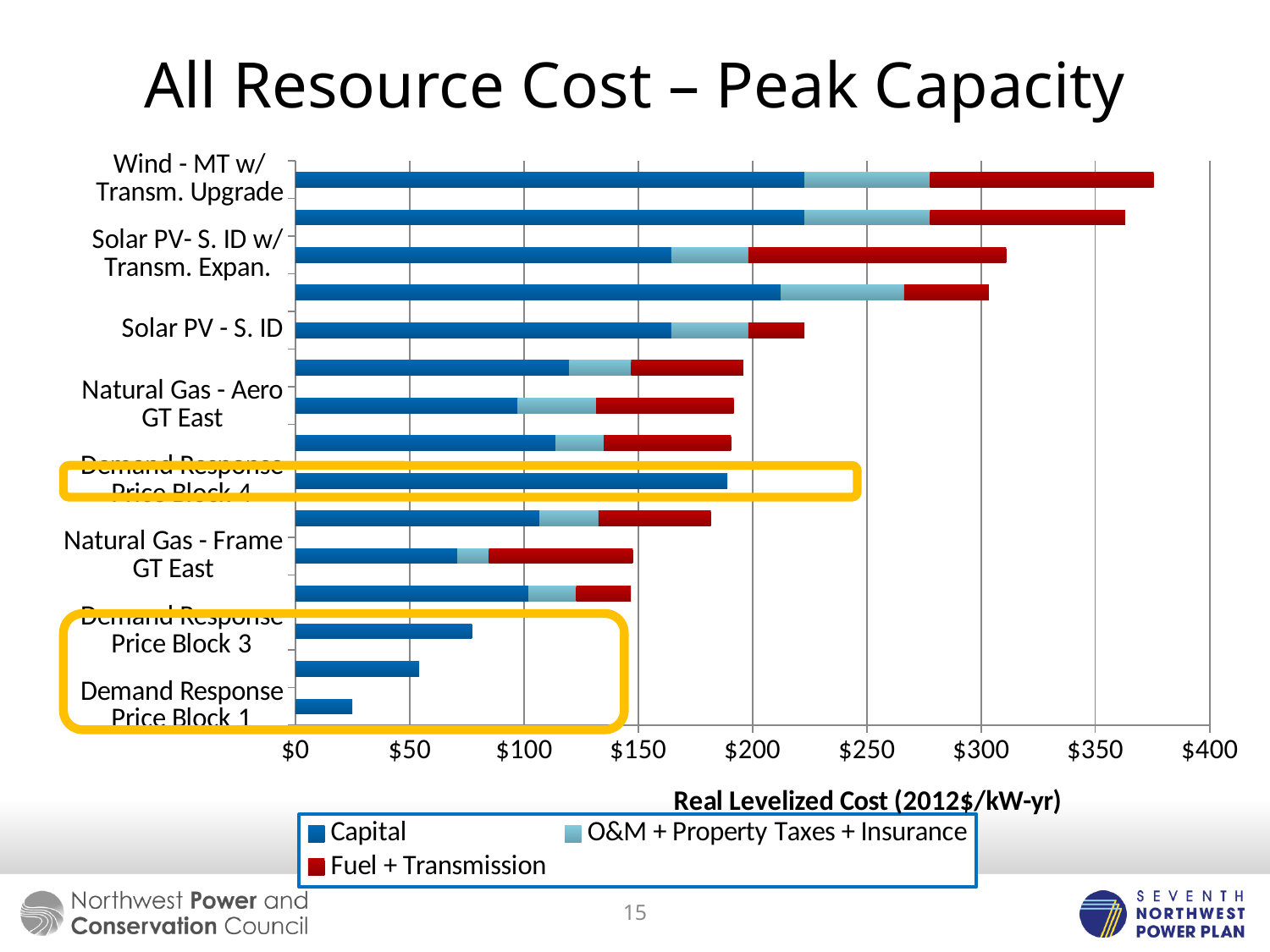
Is the cost for Demand Response Price Block 4 greater or less than $200? less Which resource has the lowest total real levelized cost? Demand Response Price Block 1 Which colour represents Fuel + Transmission in the legend? Red Is the total cost for Solar PV - S. ID greater or less than $200? greater What is the title of the x axis? Real Levelized Cost (2012$/kW-yr) Which has a larger total cost, Wind - MT w/ Transm. Upgrade or Solar PV - S. ID? Wind - MT w/ Transm. Upgrade Is the total cost for Demand Response Price Block 1 greater or less than $50? less Which resource has the highest total real levelized cost? Wind - MT w/ Transm. Upgrade What kind of chart is shown on the slide? Bar chart How many series does the legend list? 3